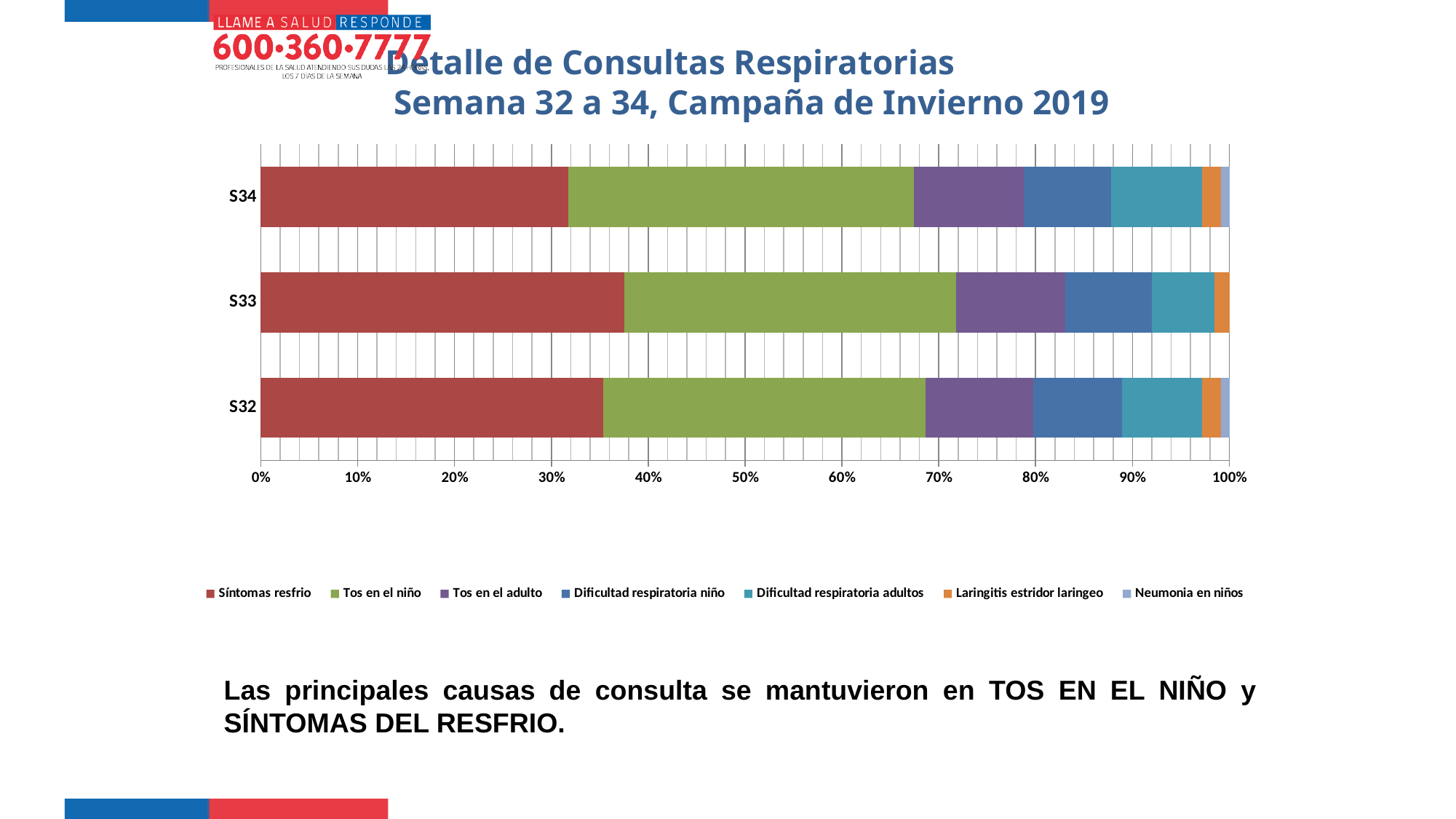
Which series is shown in red in the chart? Síntomas resfrio How many series does the legend list? 7 What is the title of the chart on the slide? Detalle de Consultas Respiratorias Semana 32 a 34, Campaña de Invierno 2019 Which week has the largest share of Síntomas resfrio? S33 Which week has the smallest share of Síntomas resfrio? S34 Is the share of Síntomas resfrio for S32 greater or less than 40%? less Is the share of Síntomas resfrio for S33 greater or less than 30%? greater What kind of chart is shown on the slide? Stacked bar chart Is the share of Síntomas resfrio for S34 greater or less than 40%? less Which week has the larger share of Síntomas resfrio, S33 or S34? S33 How many weeks (categories) are plotted on the chart? 3